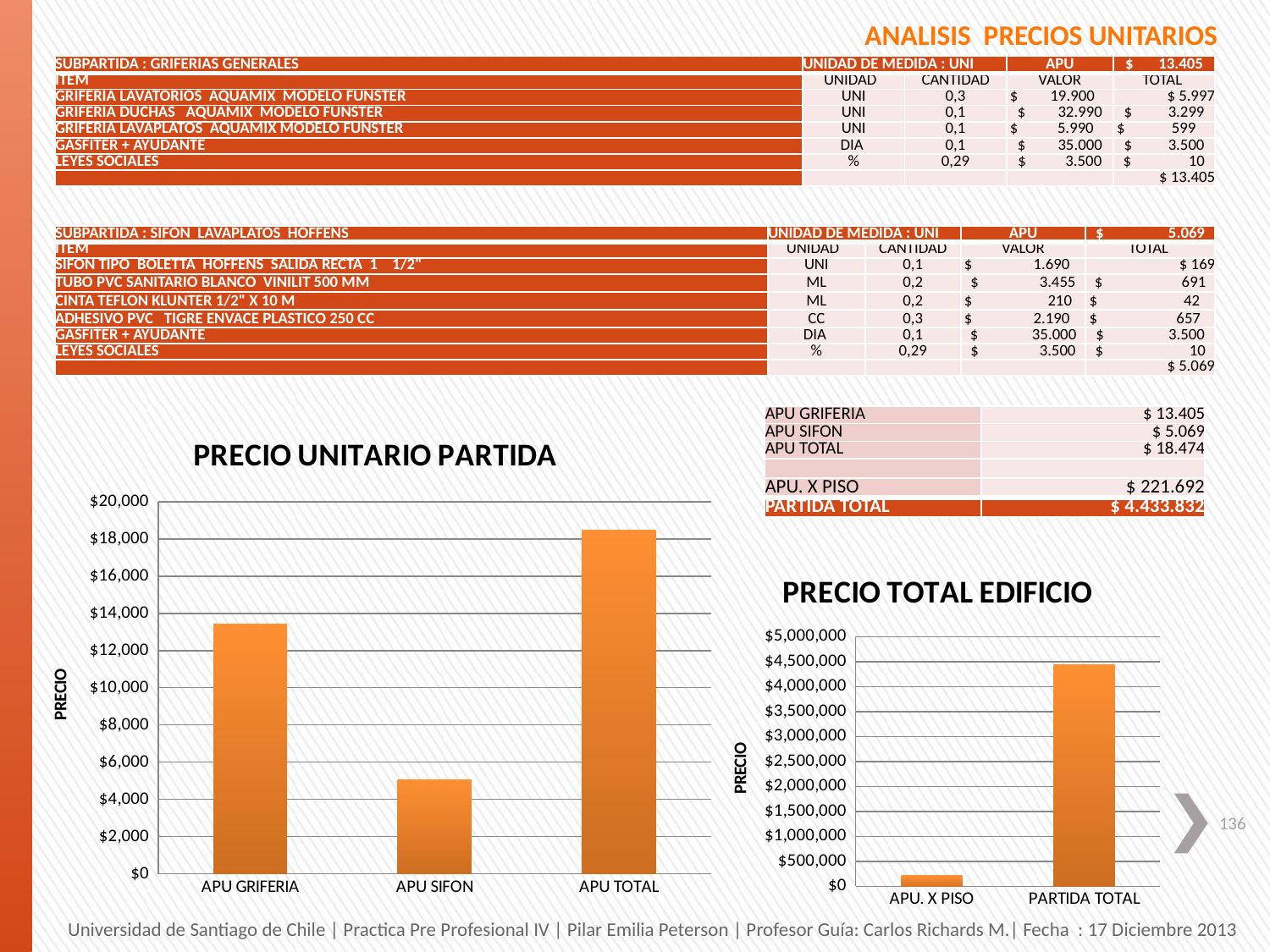
In the 'PRECIO UNITARIO PARTIDA' chart, is the value for APU TOTAL greater or less than $18,000? greater In the 'PRECIO UNITARIO PARTIDA' chart, is the value for APU SIFON greater or less than $6,000? less How many categories are shown in the 'PRECIO UNITARIO PARTIDA' chart? 3 In the 'PRECIO TOTAL EDIFICIO' chart, which category has the highest value? PARTIDA TOTAL In the 'PRECIO UNITARIO PARTIDA' chart, which is larger, APU GRIFERIA or APU SIFON? APU GRIFERIA In the 'PRECIO UNITARIO PARTIDA' chart, which category has the lowest value? APU SIFON In the 'PRECIO UNITARIO PARTIDA' chart, which category has the highest value? APU TOTAL What is the label on the vertical axis of the 'PRECIO TOTAL EDIFICIO' chart? PRECIO What kind of chart is the 'PRECIO UNITARIO PARTIDA' chart? bar chart How many categories are shown in the 'PRECIO TOTAL EDIFICIO' chart? 2 In the 'PRECIO UNITARIO PARTIDA' chart, is the value for APU GRIFERIA greater or less than $12,000? greater